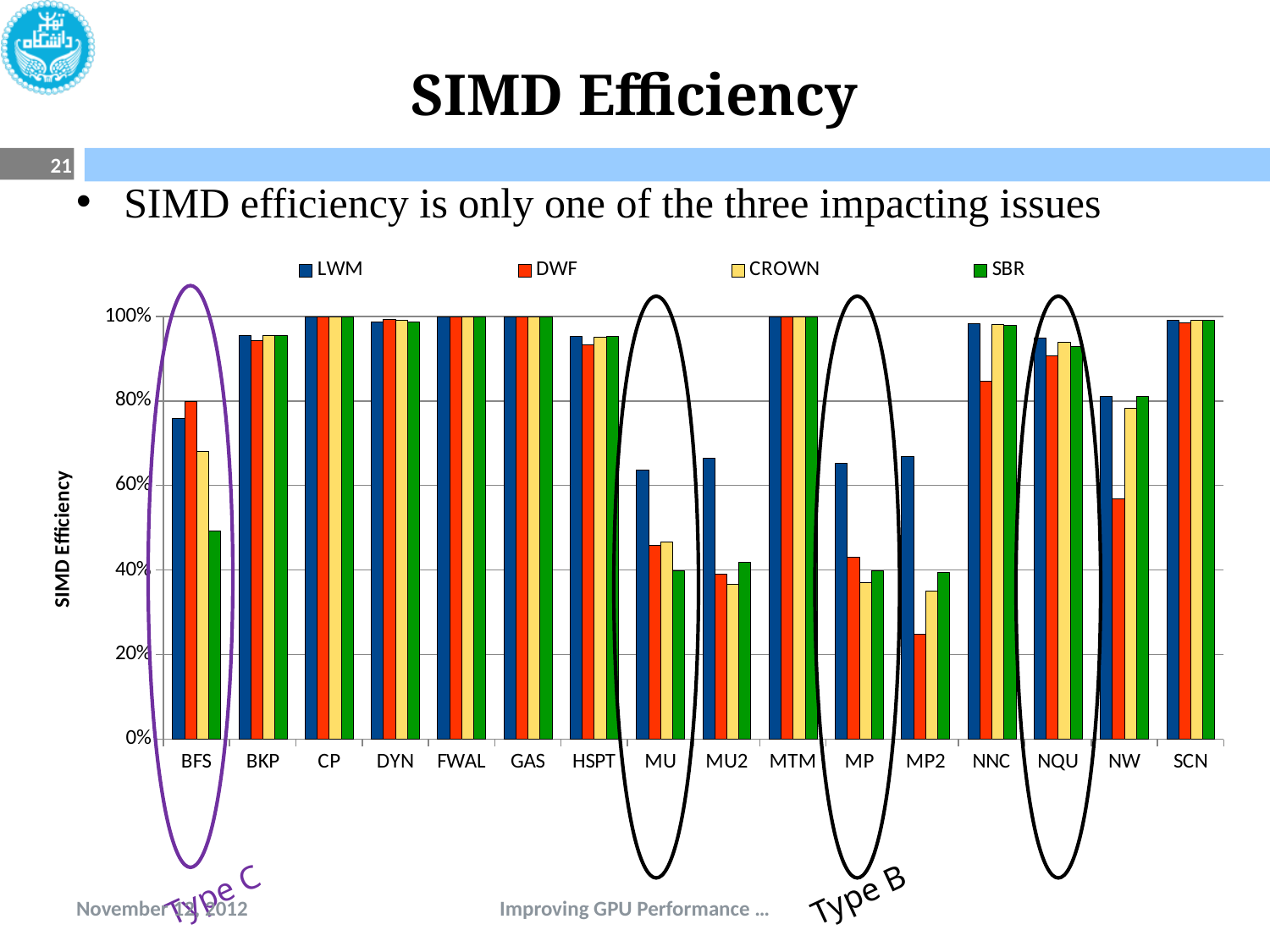
Is the DWF value for MP2 greater or less than 40%? less How many benchmark categories are shown on the x axis? 16 What is the label on the vertical axis? SIMD Efficiency Is the DWF value for NW greater or less than 80%? less Which category has the lowest DWF value? MP2 How many series does the legend list? 4 Is the DWF value for NNC greater or less than 80%? greater For MP2, which is larger: the LWM value or the DWF value? LWM For BFS, which is larger: the LWM value or the SBR value? LWM What kind of chart is shown on the slide? bar chart